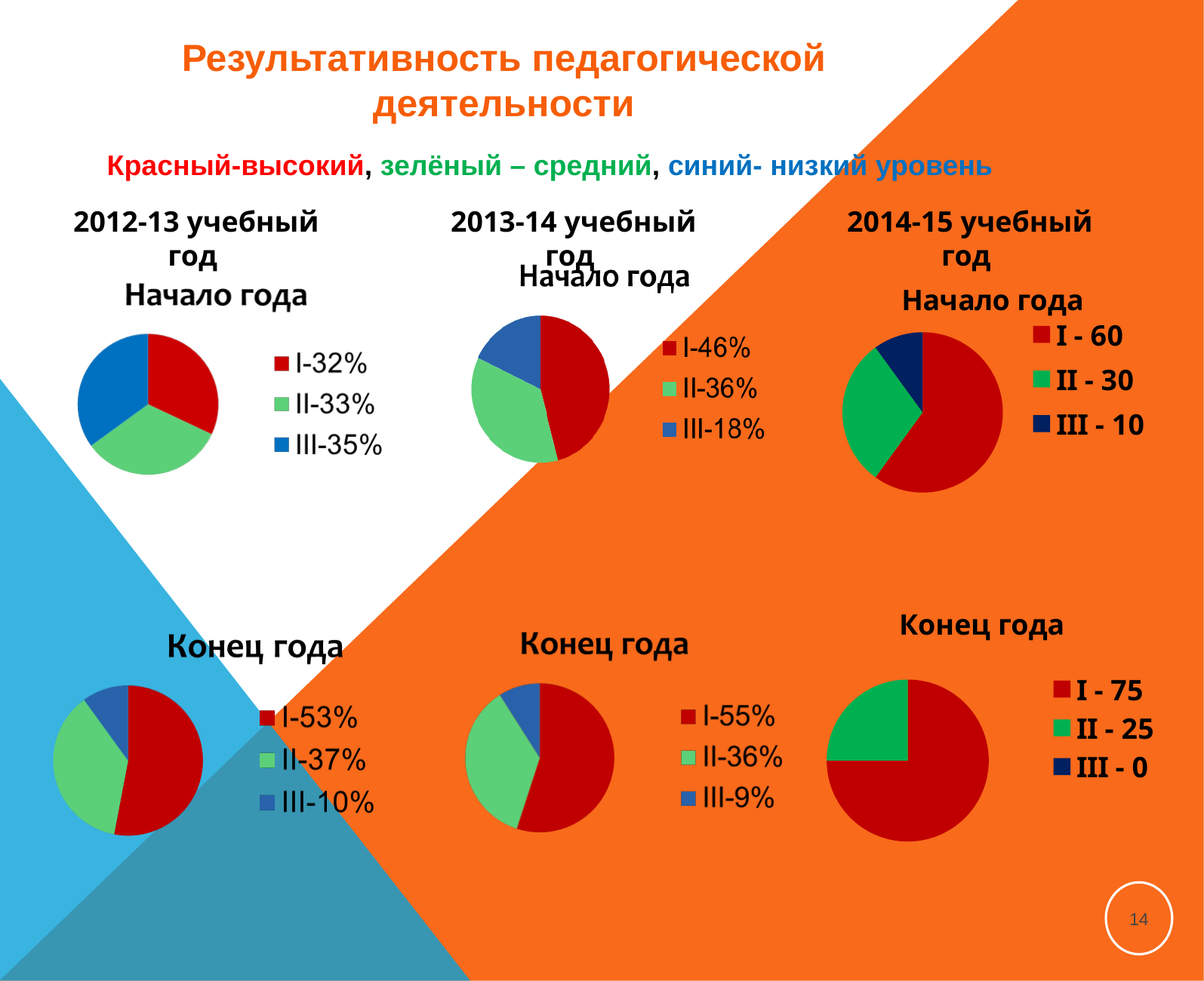
In the 2014-15 'Начало года' pie chart, what is the value for category I? 60 In the 2012-13 'Начало года' pie chart, which category has the largest share? III In the 2014-15 'Конец года' pie chart, which is larger, category I or category II? I In the 2013-14 'Начало года' pie chart, what is the value for category II? 36% In the 2012-13 'Начало года' pie chart, what is the value for category III? 35% How many pie charts are shown on the slide? 6 In the 2012-13 'Конец года' pie chart, what is the value for category I? 53% In the 2013-14 'Конец года' pie chart, which category has the smallest share? III In the 2013-14 'Конец года' pie chart, what is the difference between the values for category I and category II? 19% In the 2014-15 'Конец года' pie chart, what is the value for category III? 0 What type of chart is used for the 2013-14 'Начало года' data? Pie chart How many entries does the legend of the 2014-15 'Начало года' chart list? 3